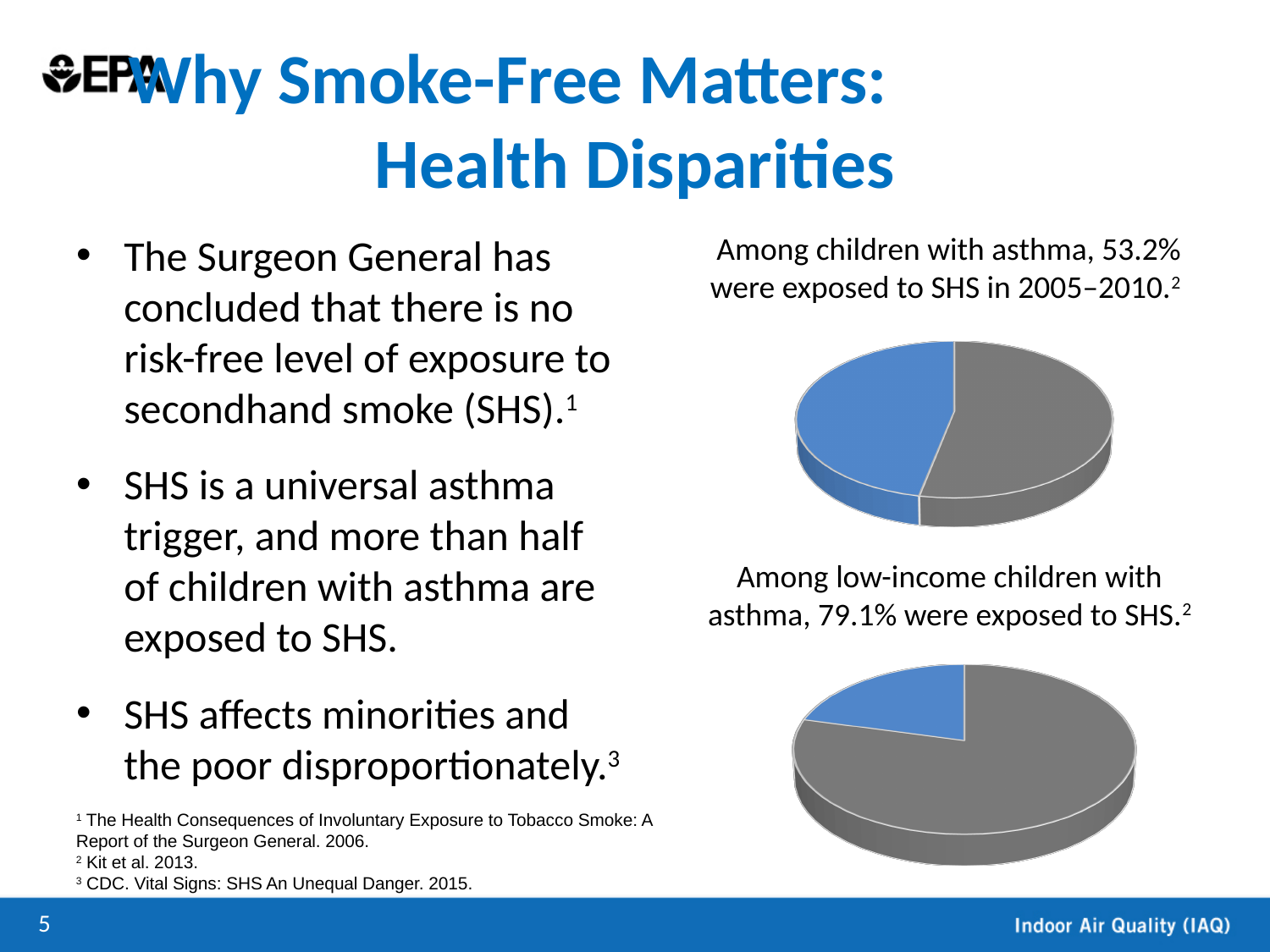
What two colours are used for the slices in the pie charts? Gray and blue What kind of chart is shown under the heading "Among low-income children with asthma, 79.1% were exposed to SHS"? Pie chart How many pie charts are shown on the slide? 2 Which pie chart shows the larger share exposed to SHS, the one for all children with asthma or the one for low-income children with asthma? Low-income children with asthma What is the difference between the SHS exposure share for low-income children with asthma (79.1%) and for all children with asthma (53.2%), as given in the chart headings? 25.9% How many slices does the top pie chart (children with asthma) have? 2 In the top pie chart (children with asthma), which slice is larger, the gray one or the blue one? Gray According to the heading of the bottom pie chart, what share of low-income children with asthma were exposed to SHS? 79.1% How many slices does the bottom pie chart (low-income children with asthma) have? 2 What kind of chart is shown under the heading "Among children with asthma, 53.2% were exposed to SHS in 2005–2010"? Pie chart According to the heading of the top pie chart, what share of children with asthma were exposed to SHS in 2005–2010? 53.2% In the bottom pie chart (low-income children with asthma), which slice is larger, the gray one or the blue one? Gray